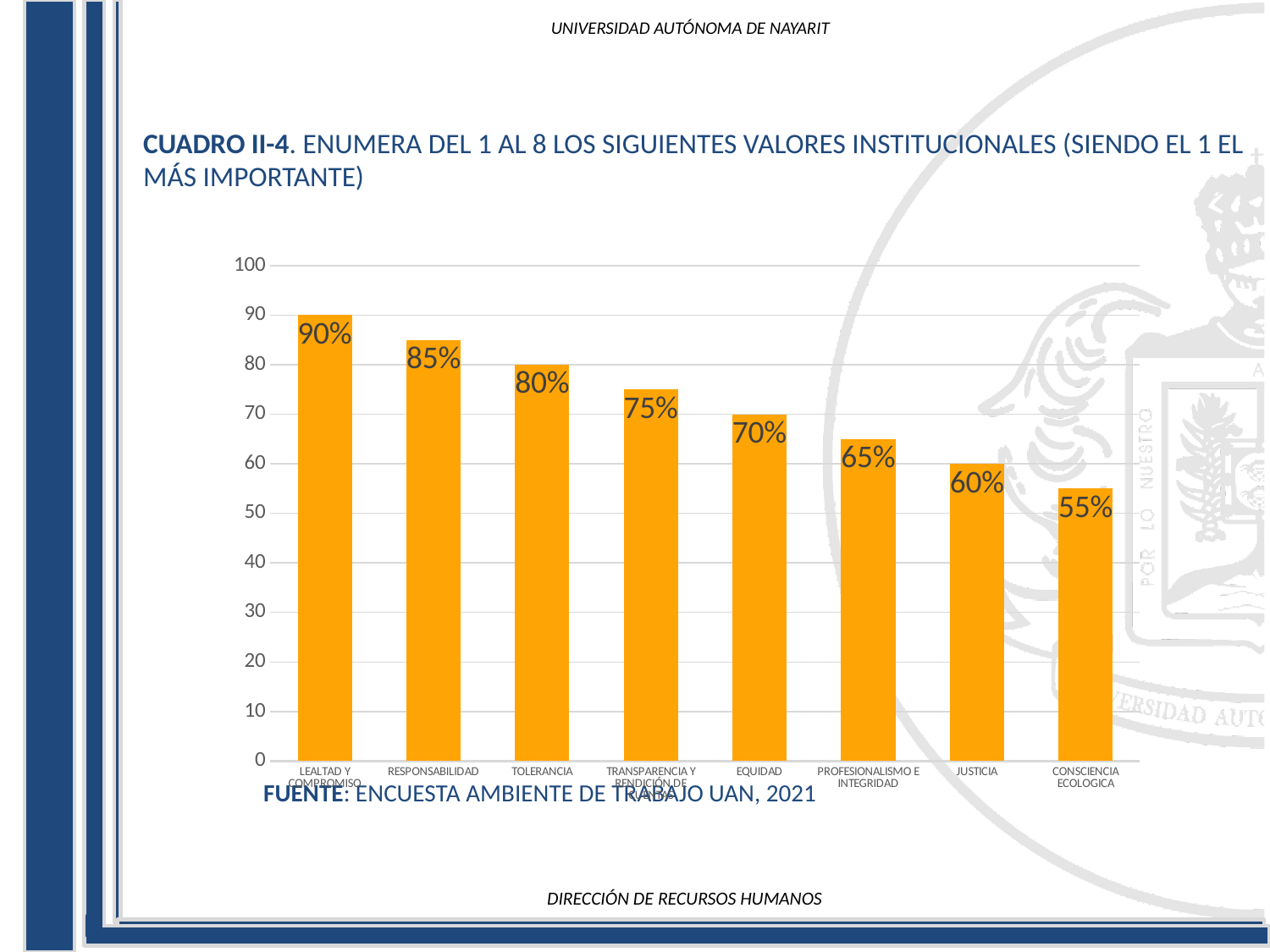
Which is larger, the value for TOLERANCIA or the value for JUSTICIA? TOLERANCIA Do the values rise or fall from left to right along the x axis? fall What colour are the bars in the chart? orange What is the value for JUSTICIA? 60% What is the value for EQUIDAD? 70% Is the value for CONSCIENCIA ECOLOGICA greater or less than 60? less Which category has the highest value? LEALTAD Y COMPROMISO What is the difference between the values for RESPONSABILIDAD and PROFESIONALISMO E INTEGRIDAD? 20% How many categories are shown in the chart? 8 Which category has the lowest value? CONSCIENCIA ECOLOGICA What is the value for TOLERANCIA? 80% What kind of chart is shown on the slide? bar chart